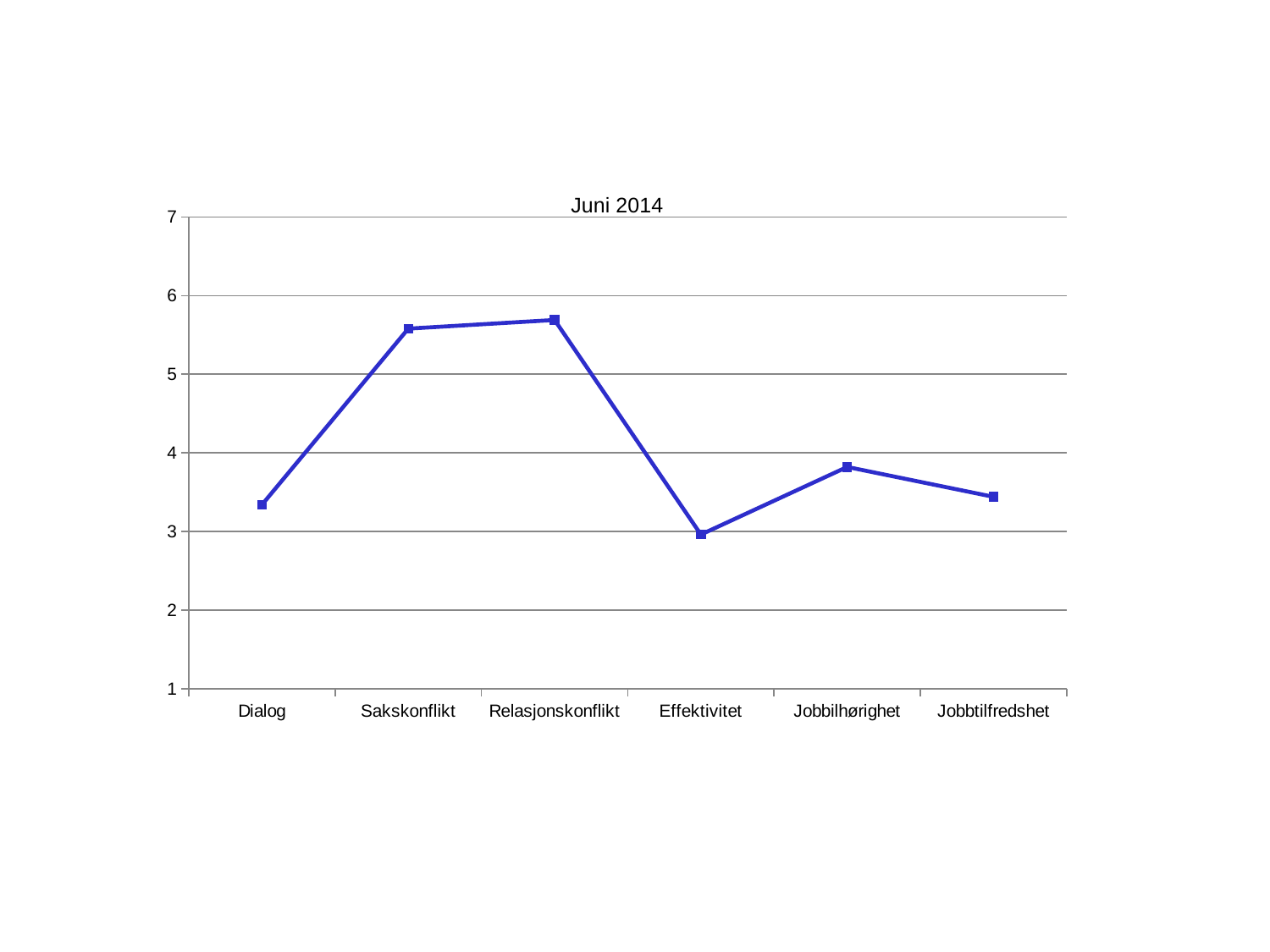
Is the value for Jobbilhørighet greater or less than 4? less Is the value for Sakskonflikt greater or less than 5? greater What is the title of the chart? Juni 2014 Does the line rise or fall from Relasjonskonflikt to Effektivitet? fall Is the value for Jobbtilfredshet greater or less than 3? greater Which is larger, the value for Jobbilhørighet or the value for Jobbtilfredshet? Jobbilhørighet Which category has the lowest value? Effektivitet Which is larger, the value for Sakskonflikt or the value for Effektivitet? Sakskonflikt How many categories are plotted along the x axis? 6 What kind of chart is shown on the slide? line chart